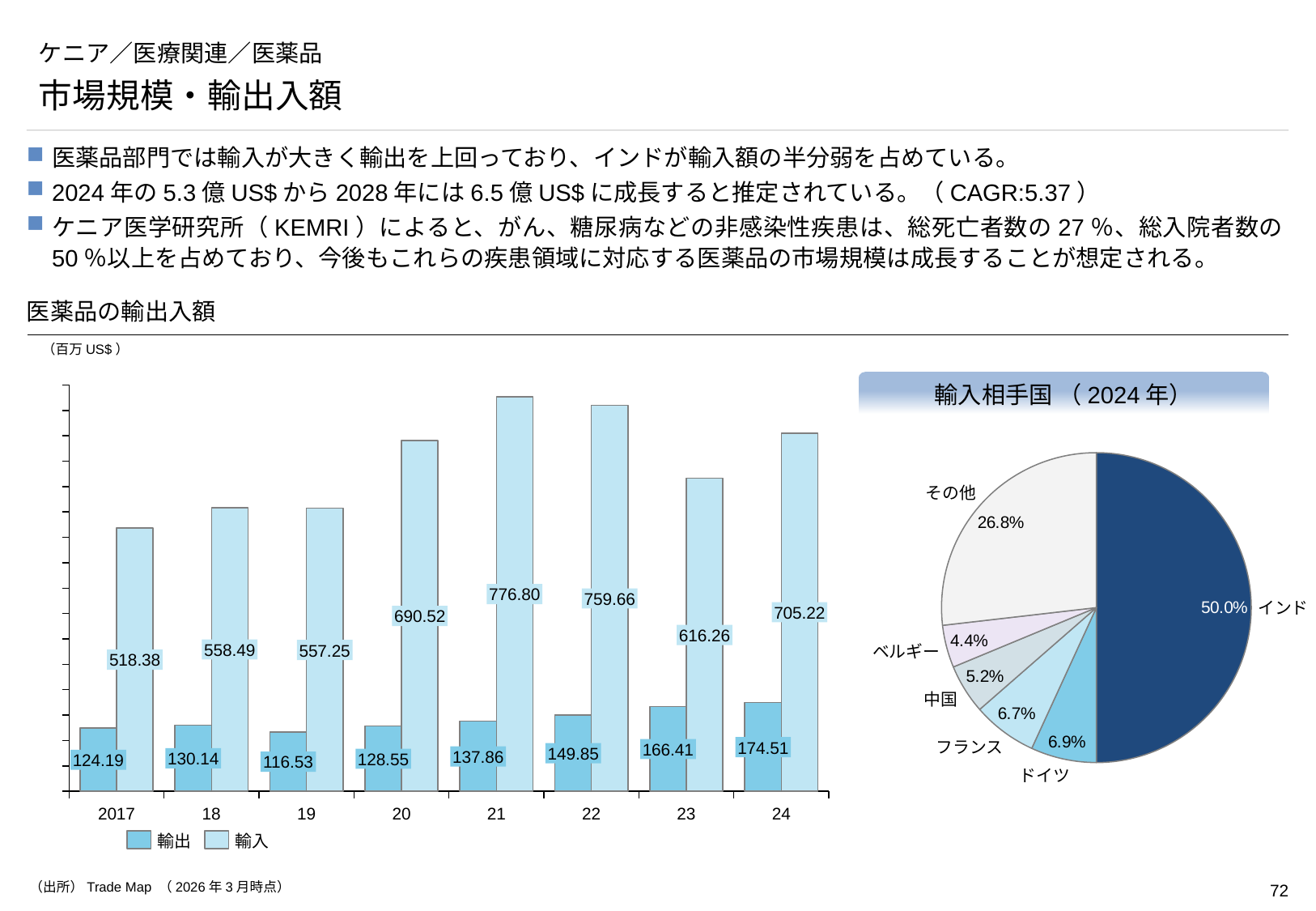
In the pie chart 輸入相手国（2024年）, which named country has the smallest share? ベルギー What kind of chart is 医薬品の輸出入額? bar chart In the pie chart 輸入相手国（2024年）, what share does インド have? 50.0% In the bar chart 医薬品の輸出入額, how many series does the legend list? 2 In the bar chart 医薬品の輸出入額, how many years are shown on the x axis? 8 In the pie chart 輸入相手国（2024年）, how many slices are there? 6 In the bar chart 医薬品の輸出入額, what is the difference between the 輸入 and 輸出 values for 2024? 530.71 In the bar chart 医薬品の輸出入額, what is the 輸入 value for 2021? 776.80 In the bar chart 医薬品の輸出入額, which year has the highest 輸入 value? 2021 In the bar chart 医薬品の輸出入額, which is larger: the 輸入 value for 2022 or the 輸入 value for 2023? 2022 In the bar chart 医薬品の輸出入額, which year has the lowest 輸出 value? 2019 In the bar chart 医薬品の輸出入額, what is the 輸出 value for 2024? 174.51